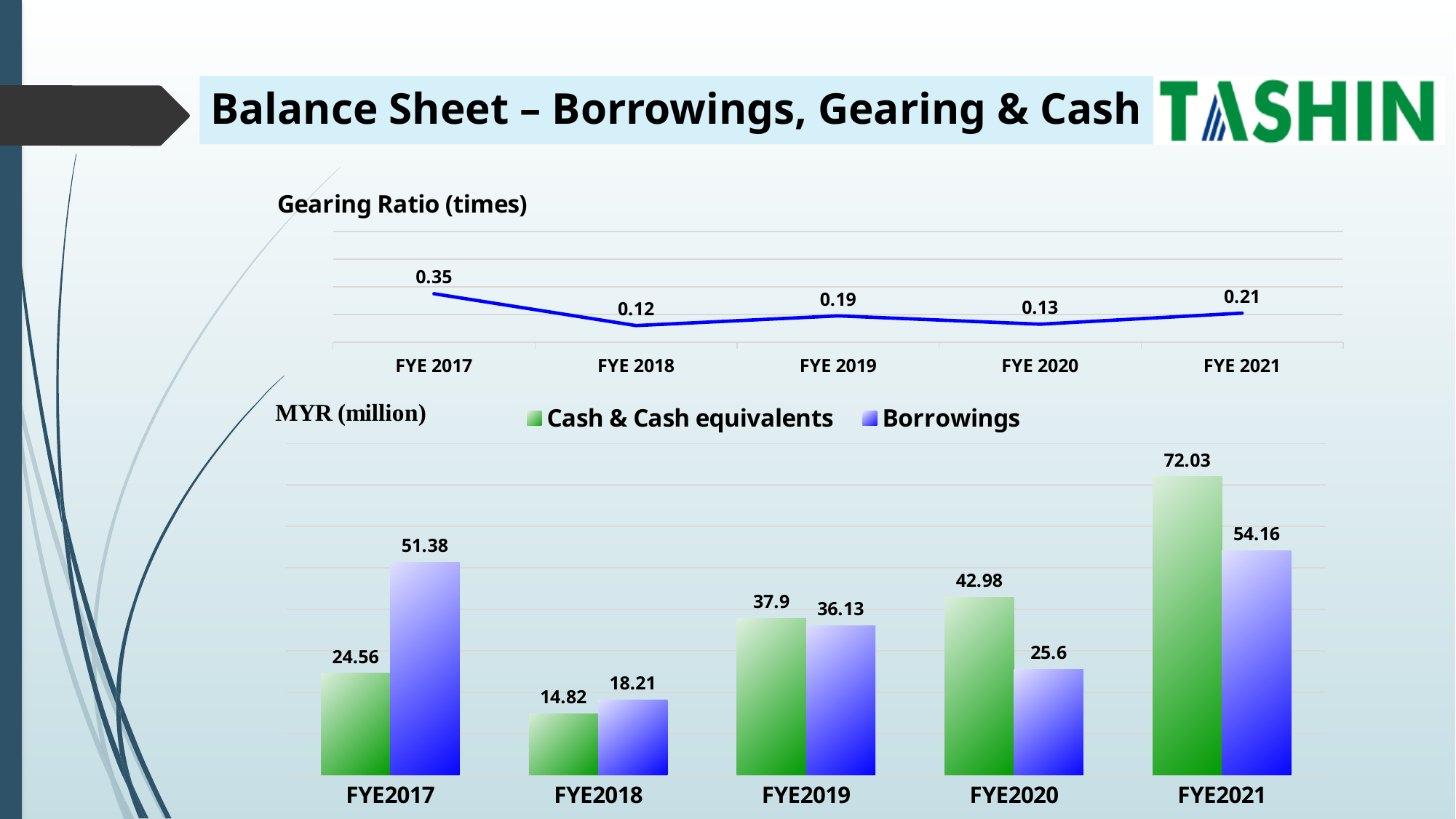
In the Gearing Ratio (times) chart, what is the gearing ratio for FYE 2017? 0.35 In the bottom bar chart, what is the value of Borrowings for FYE2019? 36.13 In the bottom bar chart, which year has the highest Cash & Cash equivalents? FYE2021 In the Gearing Ratio (times) chart, what is the difference between the gearing ratio in FYE 2021 and FYE 2020? 0.08 In the bottom bar chart, which is larger for FYE2017, Cash & Cash equivalents or Borrowings? Borrowings In the Gearing Ratio (times) chart, how many years are plotted? 5 In the bottom bar chart, how many series does the legend list? 2 In the bottom bar chart, what is the value of Cash & Cash equivalents for FYE2021? 72.03 In the bottom bar chart, what unit is shown for the values? MYR (million) In the bottom bar chart, what is the difference between Cash & Cash equivalents and Borrowings in FYE2020? 17.38 In the Gearing Ratio (times) chart, what kind of chart is used? Line chart In the Gearing Ratio (times) chart, which year has the lowest gearing ratio? FYE 2018